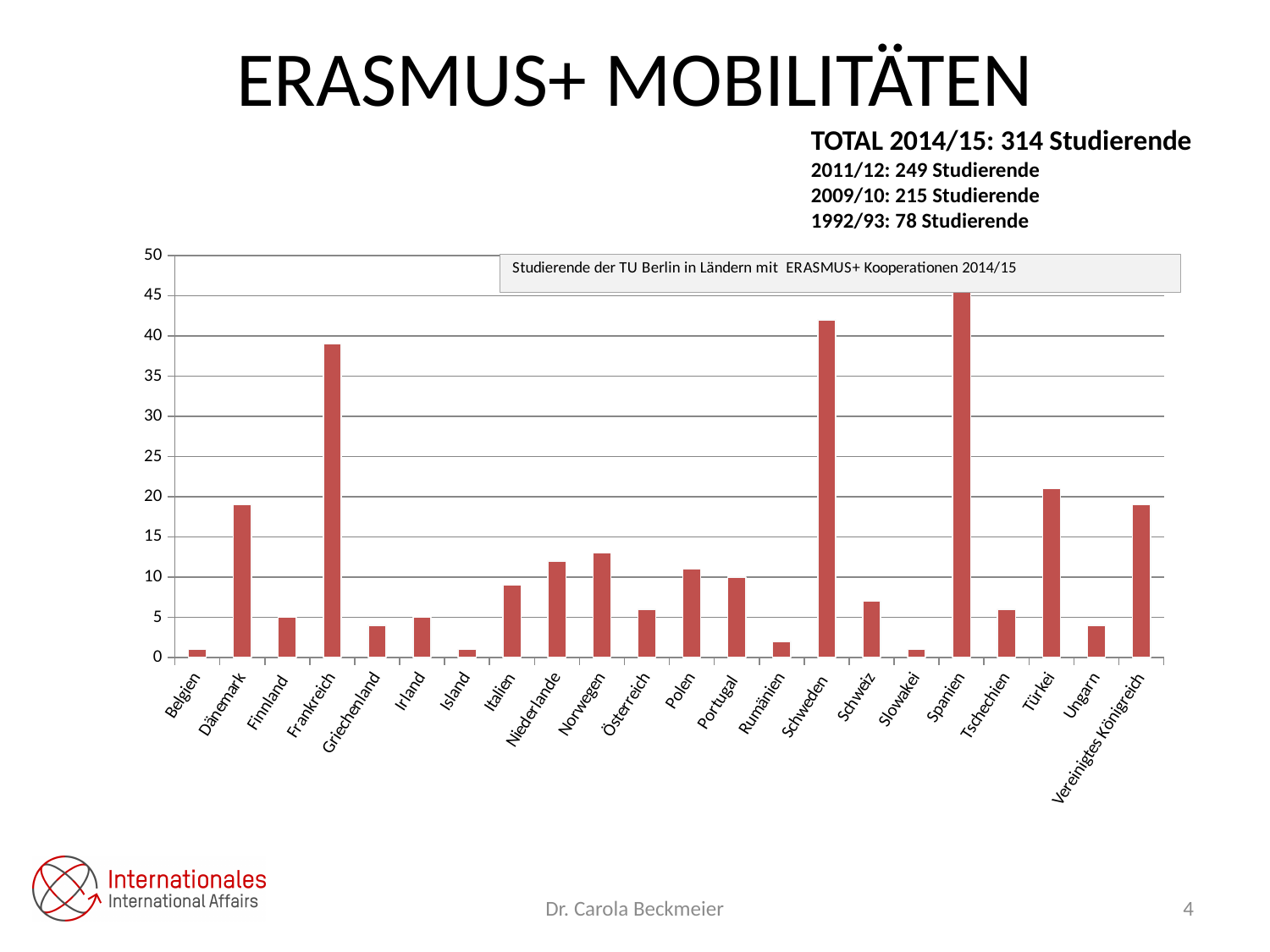
Is the value for Schweden greater or less than 40? greater Is the value for Frankreich greater or less than 35? greater Is the value for Italien greater or less than 10? less What kind of chart is shown on the slide? bar chart Which country has the highest bar in the chart? Spanien Which has the larger value, Schweden or Frankreich? Schweden How many countries are shown on the x axis of the chart? 22 Which has the larger value, Türkei or Dänemark? Türkei